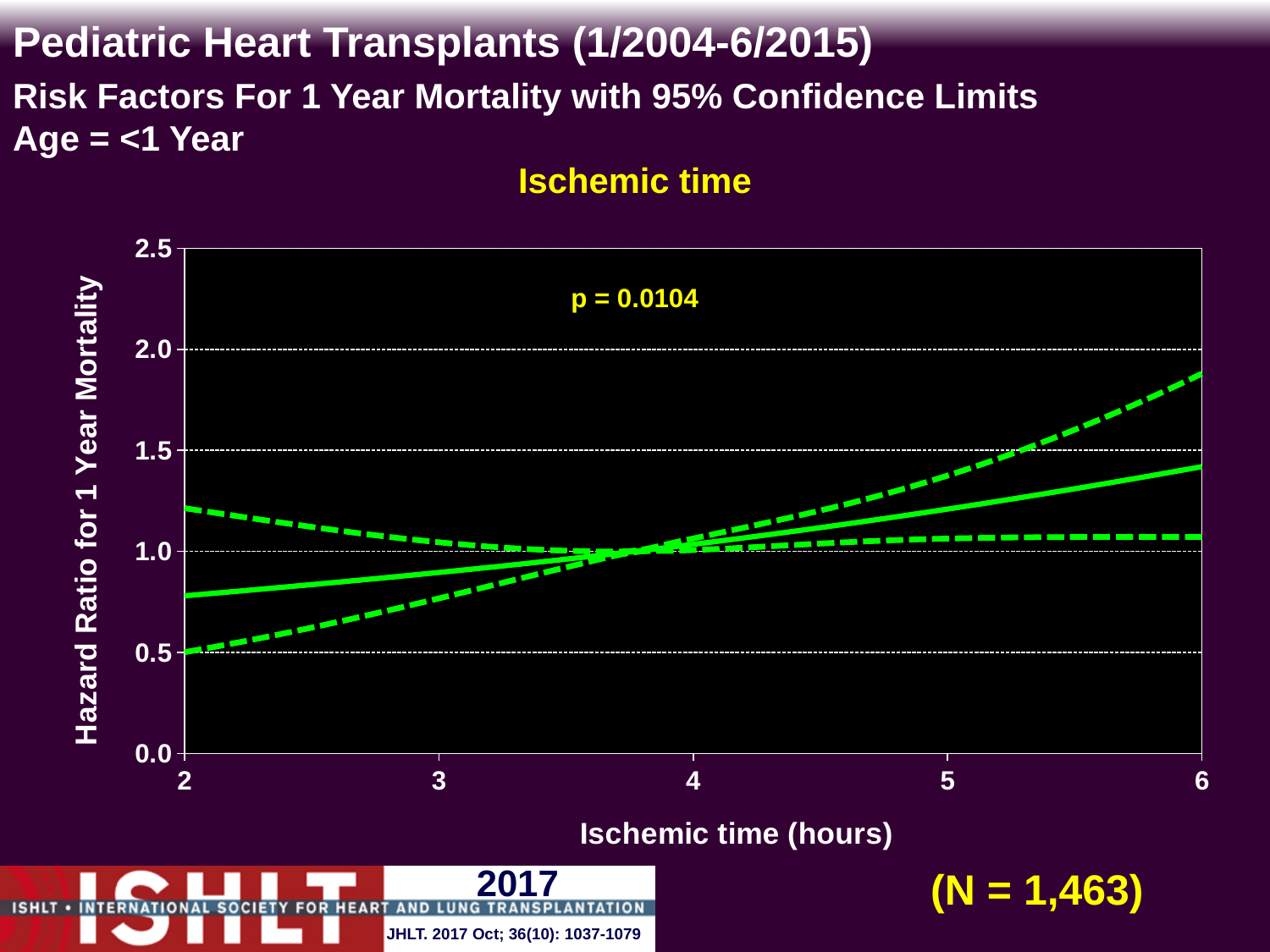
Does the solid hazard ratio line rise or fall as ischemic time increases from 2 to 6 hours? Rises Is the upper dashed confidence limit at 6 hours of ischemic time greater or less than 1.5? greater Is the solid hazard ratio line at 2 hours of ischemic time greater or less than 1.0? less How many lines are plotted on the chart? 3 Is the solid hazard ratio line at 6 hours of ischemic time greater or less than 1.5? less What kind of chart is shown on the slide? Line chart What p-value is printed on the chart? p = 0.0104 What is the title of the chart? Ischemic time